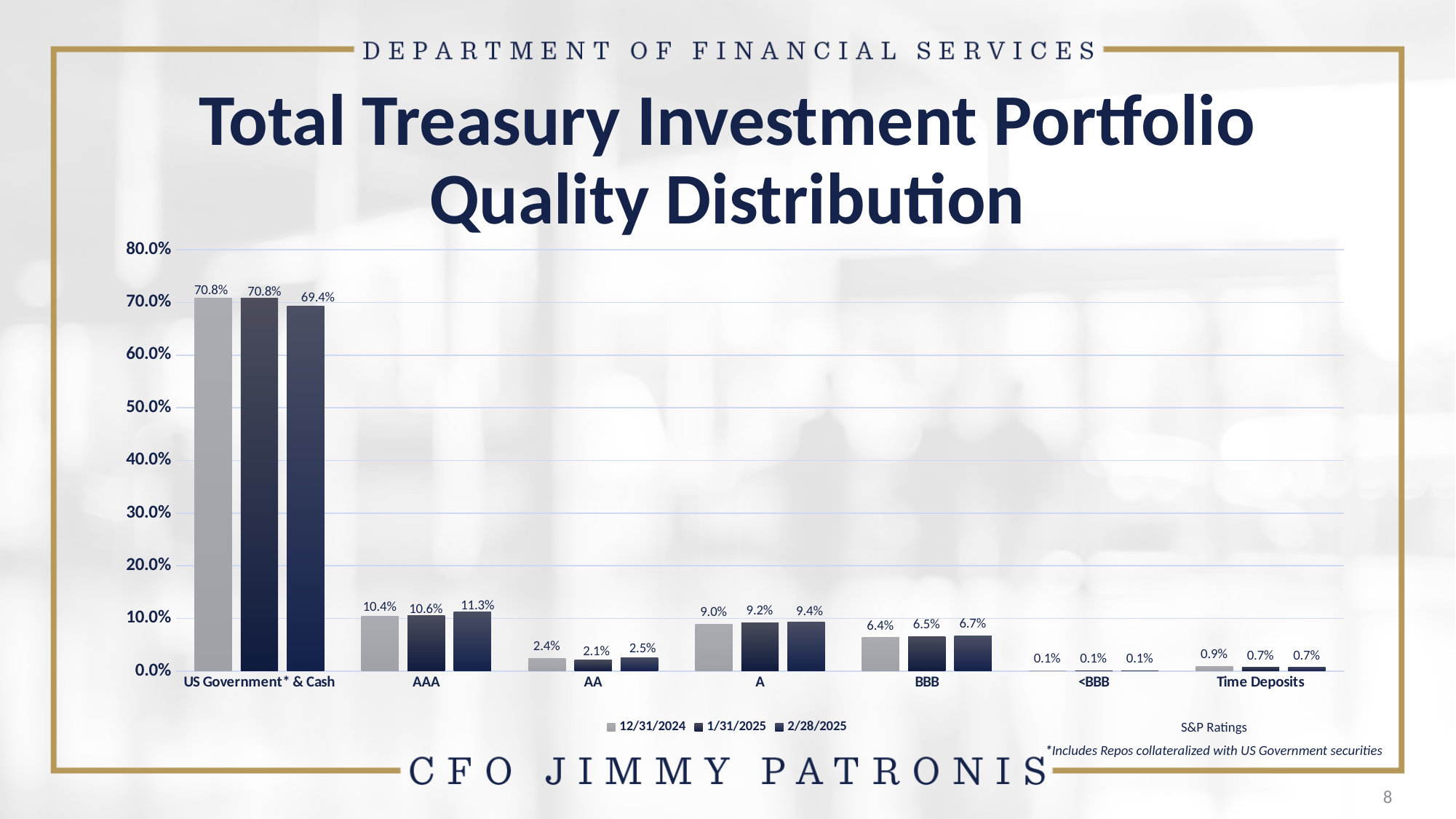
Which is larger for the A category: the 12/31/2024 value or the 2/28/2025 value? 2/28/2025 Which category has the highest value in the 2/28/2025 series? US Government* & Cash How many categories are shown on the x axis? 7 What is the value for AAA in the 12/31/2024 series? 10.4% What is the value for AA in the 1/31/2025 series? 2.1% What is the difference between the 2/28/2025 and 12/31/2024 values for AAA? 0.9% How many series does the legend list? 3 What is the value for US Government* & Cash in the 2/28/2025 series? 69.4% Which category has the lowest value in the 12/31/2024 series? <BBB What kind of chart is shown on the slide? Bar chart What is the title of the chart? Total Treasury Investment Portfolio Quality Distribution What is the value for BBB in the 2/28/2025 series? 6.7%